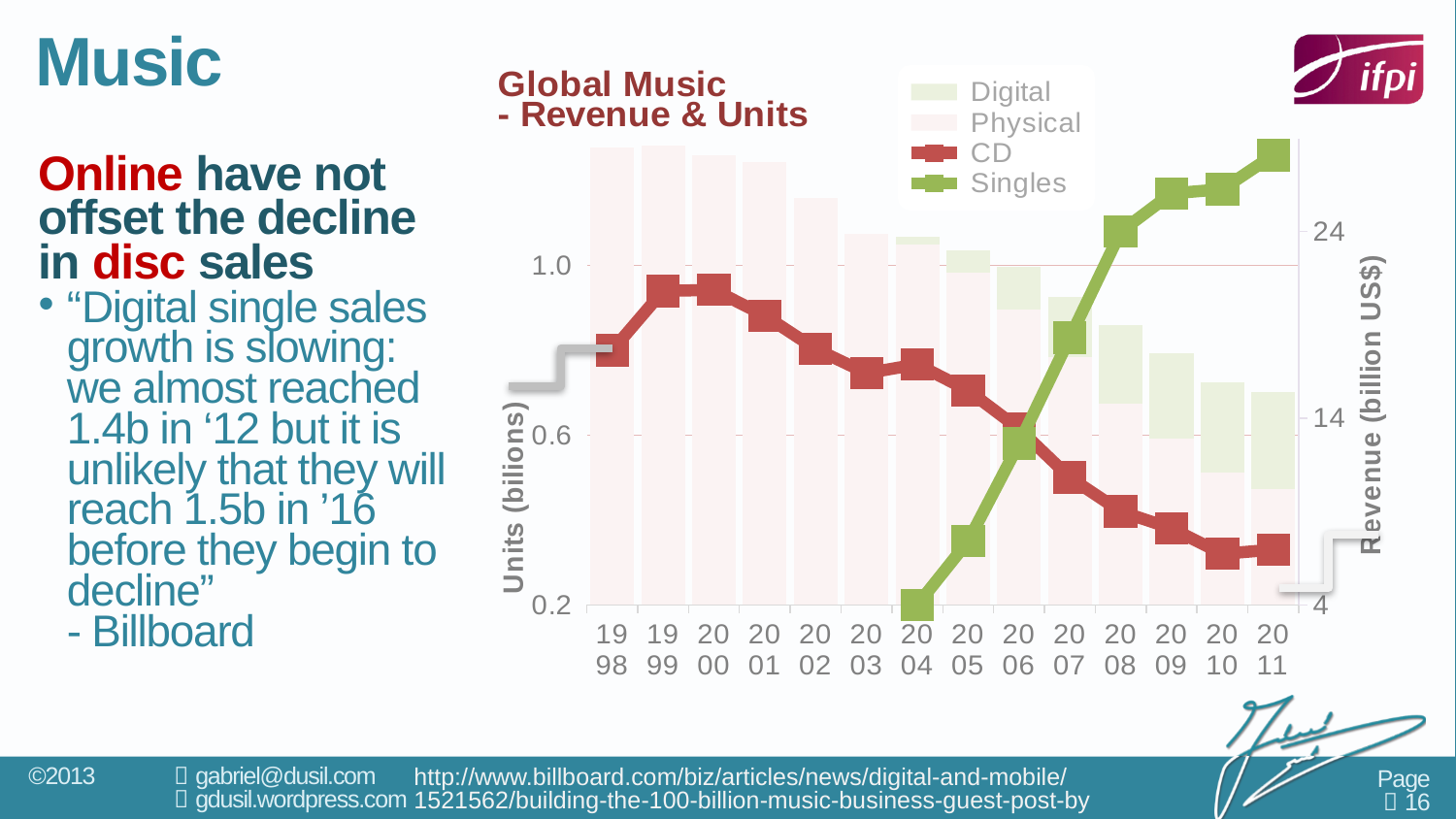
How many years are shown along the x axis of the chart? 14 In 2011, which is larger: the CD value or the Singles value? Singles Does the CD series rise or fall from 1999 to 2011? Fall What kind of chart is shown on the slide? Combined bar and line chart How many series does the chart's legend list? 4 In which year is the Singles series at its highest? 2011 Is the CD value for 1999 greater or less than 0.6 billion units? greater In which year is the Singles series at its lowest? 2004 Does the Singles series rise or fall from 2004 to 2011? Rise Is the Singles value for 2011 greater or less than 1.0 billion units? greater Which series is drawn in green in the chart? Singles What is the title of the chart on the slide? Global Music - Revenue & Units